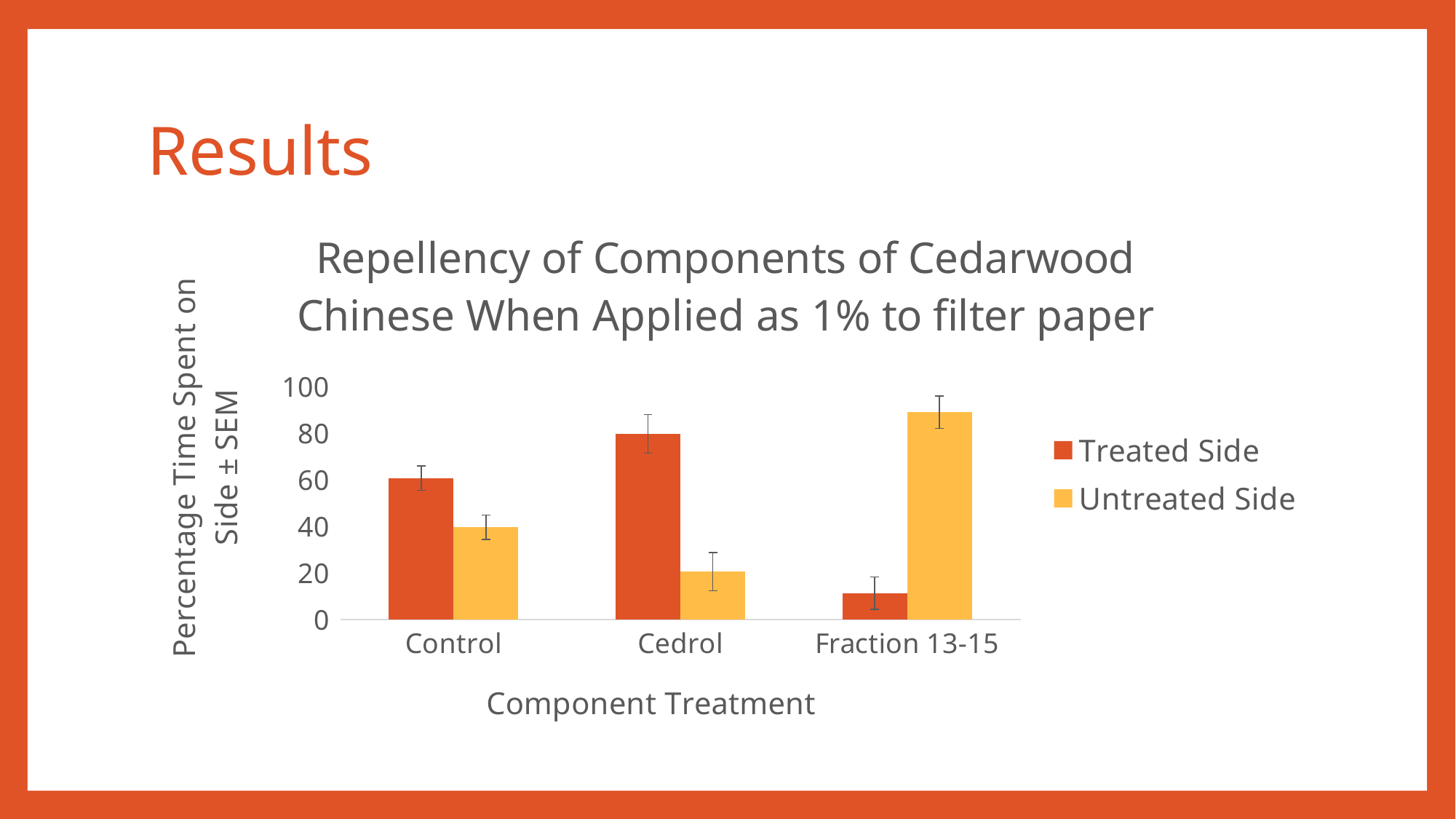
What kind of chart is shown on the slide? bar chart Which component treatment has the lowest Treated Side value? Fraction 13-15 For Fraction 13-15, which is larger: Treated Side or Untreated Side? Untreated Side How many series does the legend list? 2 Which component treatment has the highest Treated Side value? Cedrol Is the Untreated Side value for Cedrol greater or less than 40? less Which component treatment has the highest Untreated Side value? Fraction 13-15 How many component treatments are shown on the x axis? 3 Is the Untreated Side value for Fraction 13-15 greater or less than 80? greater For Cedrol, which is larger: Treated Side or Untreated Side? Treated Side What is the title of the x axis? Component Treatment For Control, which is larger: Treated Side or Untreated Side? Treated Side